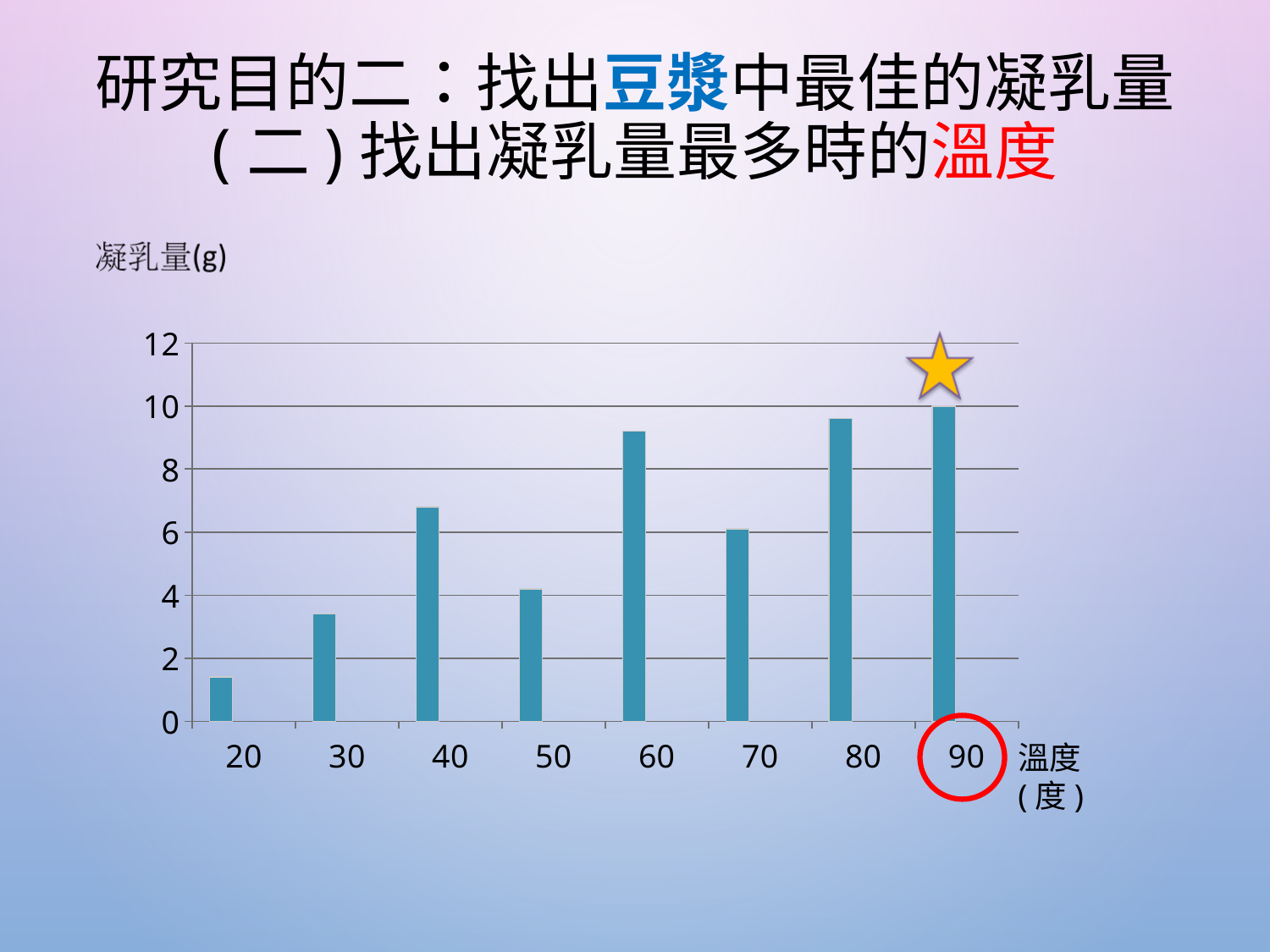
Which temperature has the lowest 凝乳量? 20 Which has the larger 凝乳量, 60 degrees or 70 degrees? 60 Is the value for 20 degrees greater or less than 2? less What kind of chart is shown on the slide? bar chart What is the label of the y axis? 凝乳量(g) Is the value for 50 degrees greater or less than 6? less Which x-axis category is circled in red? 90 Is the value for 80 degrees greater or less than 8? greater How many temperature categories are plotted on the x axis? 8 Which temperature has the highest 凝乳量? 90 What is the 凝乳量 value at 90 degrees? 10